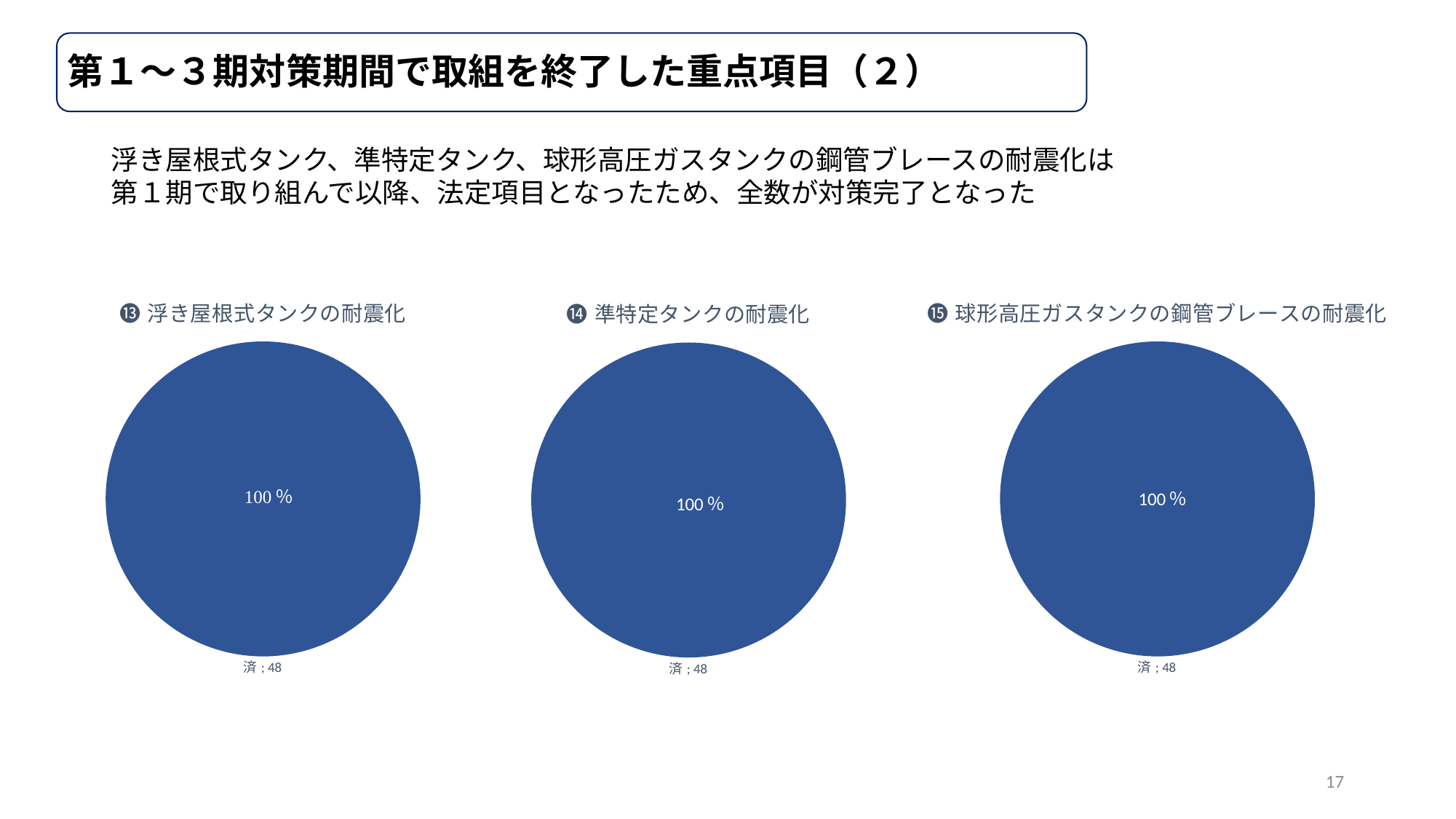
How many pie charts are shown on the slide? 3 How many slices does the middle chart 「⑭ 準特定タンクの耐震化」 have? 1 What is the title of the middle chart on the slide? ⑭ 準特定タンクの耐震化 In the right chart 「⑮ 球形高圧ガスタンクの鋼管ブレースの耐震化」, what value is printed for 済? 48 In the left chart 「⑬ 浮き屋根式タンクの耐震化」, what value is printed for 済? 48 In the left chart 「⑬ 浮き屋根式タンクの耐震化」, what share of the pie does 済 take? 100 % In the right chart 「⑮ 球形高圧ガスタンクの鋼管ブレースの耐震化」, what share of the pie does 済 take? 100 % In the middle chart 「⑭ 準特定タンクの耐震化」, what value is printed for 済? 48 What is the title of the right chart on the slide? ⑮ 球形高圧ガスタンクの鋼管ブレースの耐震化 What kind of chart is the left chart titled 「⑬ 浮き屋根式タンクの耐震化」? pie chart In the middle chart 「⑭ 準特定タンクの耐震化」, what share of the pie does 済 take? 100 %